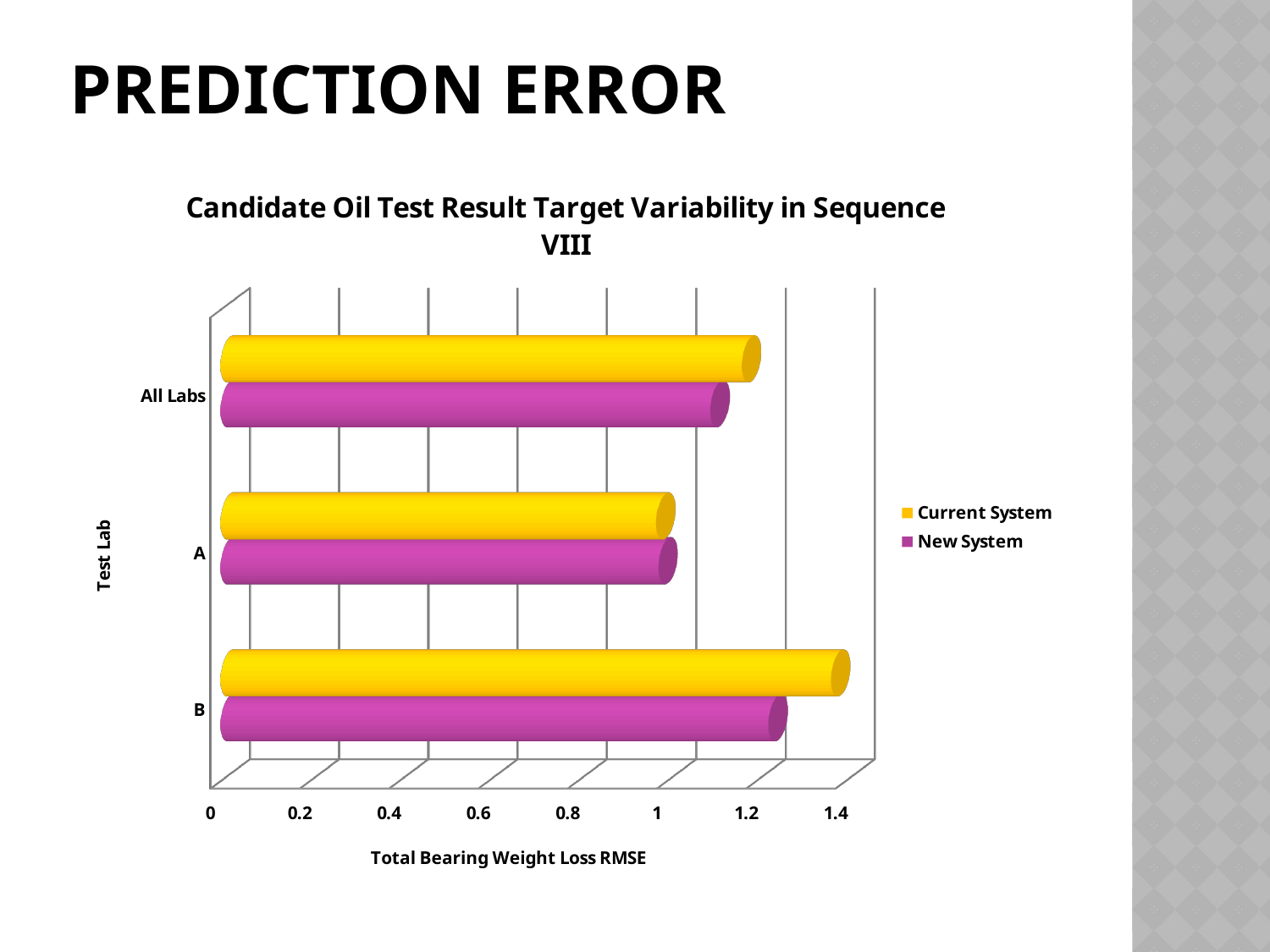
Is the Current System value for test lab A greater or less than 1.2? less For All Labs, which is larger: the Current System value or the New System value? Current System How many test lab categories are shown on the chart? 3 Which test lab has the highest Current System value? B Is the Current System value for test lab B greater or less than 1.2? greater How many series does the legend list? 2 What is the title of the chart? Candidate Oil Test Result Target Variability in Sequence VIII Which test lab has the highest New System value? B Which test lab has the lowest Current System value? A What is the label of the horizontal axis? Total Bearing Weight Loss RMSE What kind of chart is shown on the slide? bar chart For test lab B, which is larger: the Current System value or the New System value? Current System